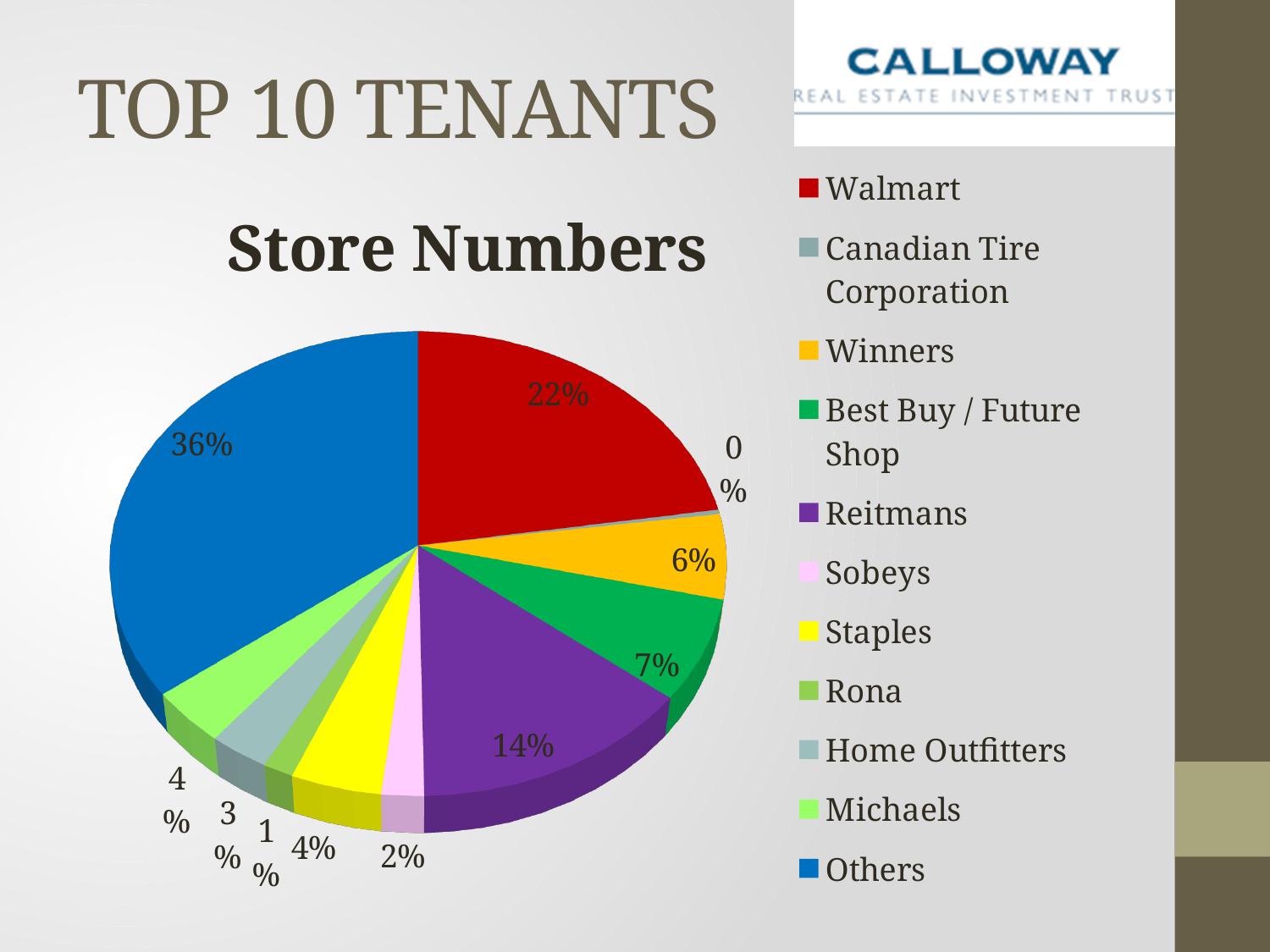
Which category has the largest slice of the pie chart? Others What percentage is shown for Winners in the pie chart? 6% Which slice is larger, Winners or Best Buy / Future Shop? Best Buy / Future Shop What is the title of the chart on the slide? Store Numbers What type of chart is shown on the slide? Pie chart What percentage is shown for Best Buy / Future Shop? 7% How many entries does the legend of the pie chart list? 11 Which tenant has the smallest slice of the pie chart? Canadian Tire Corporation What percentage is shown for Reitmans in the pie chart? 14% How many percentage points larger is Walmart's slice than Reitmans' slice? 8 What share of the pie chart is labelled for Others? 36% What percentage of the Store Numbers pie chart does Walmart account for? 22%